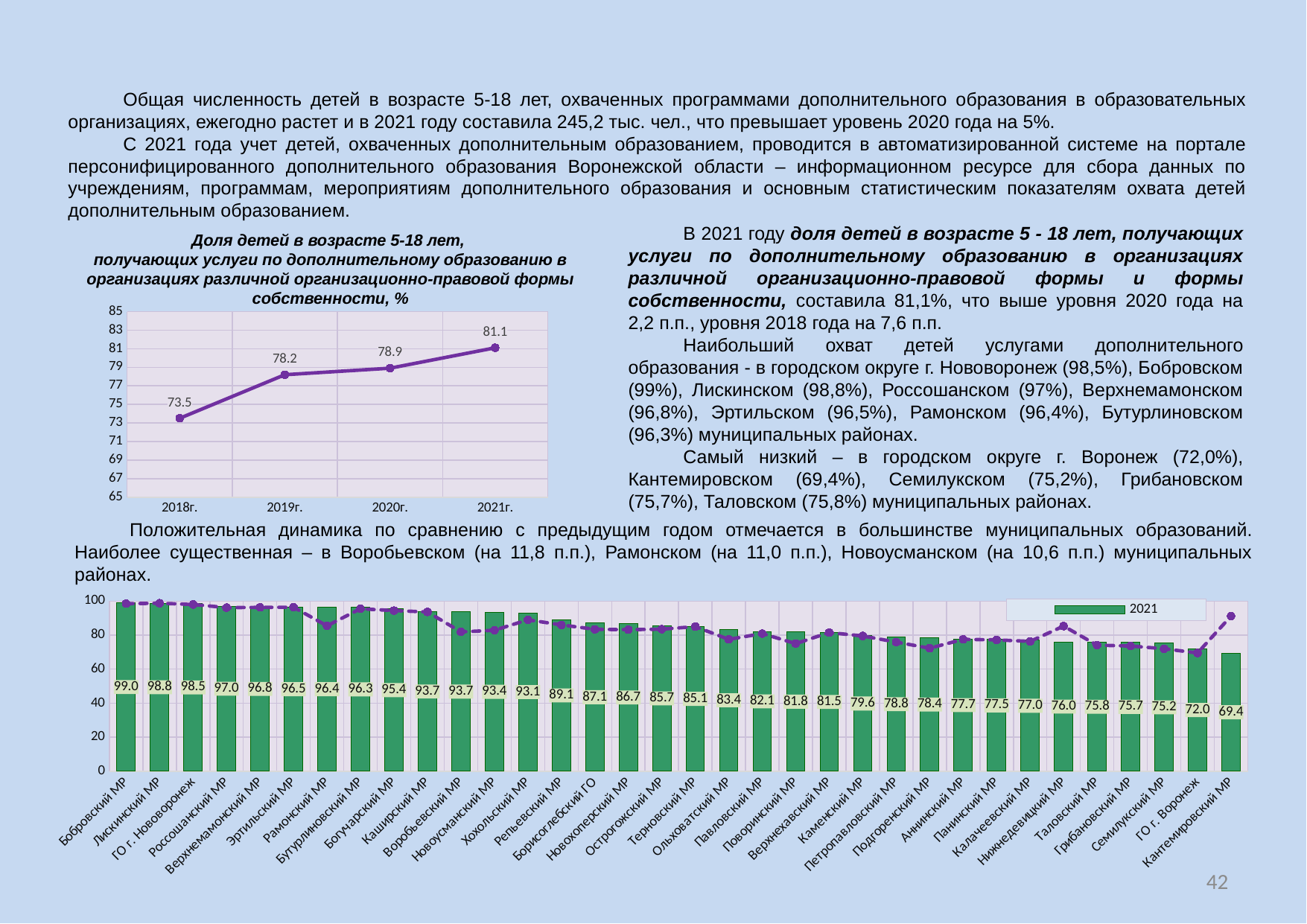
In the top-left line chart, what is the value for 2018г.? 73.5 In the top-left line chart, what is the value for 2021г.? 81.1 In the bottom bar chart, which series does the legend list? 2021 In the bottom bar chart, what is the difference between the 2021 values for Бобровский МР and ГО г. Воронеж? 27.0 In the bottom bar chart, which category has the lowest 2021 bar? Кантемировский МР In the bottom bar chart, which category has the highest 2021 bar? Бобровский МР What kind of chart is the top-left chart? line chart In the top-left line chart, how many years are plotted? 4 In the bottom bar chart, what is the 2021 value for Рамонский МР? 96.4 In the top-left line chart, do the values rise or fall from 2018г. to 2021г.? rise In the top-left line chart, by how much does the value for 2021г. exceed the value for 2018г.? 7.6 In the bottom bar chart, which has the larger 2021 value, Хохольский МР or Репьевский МР? Хохольский МР